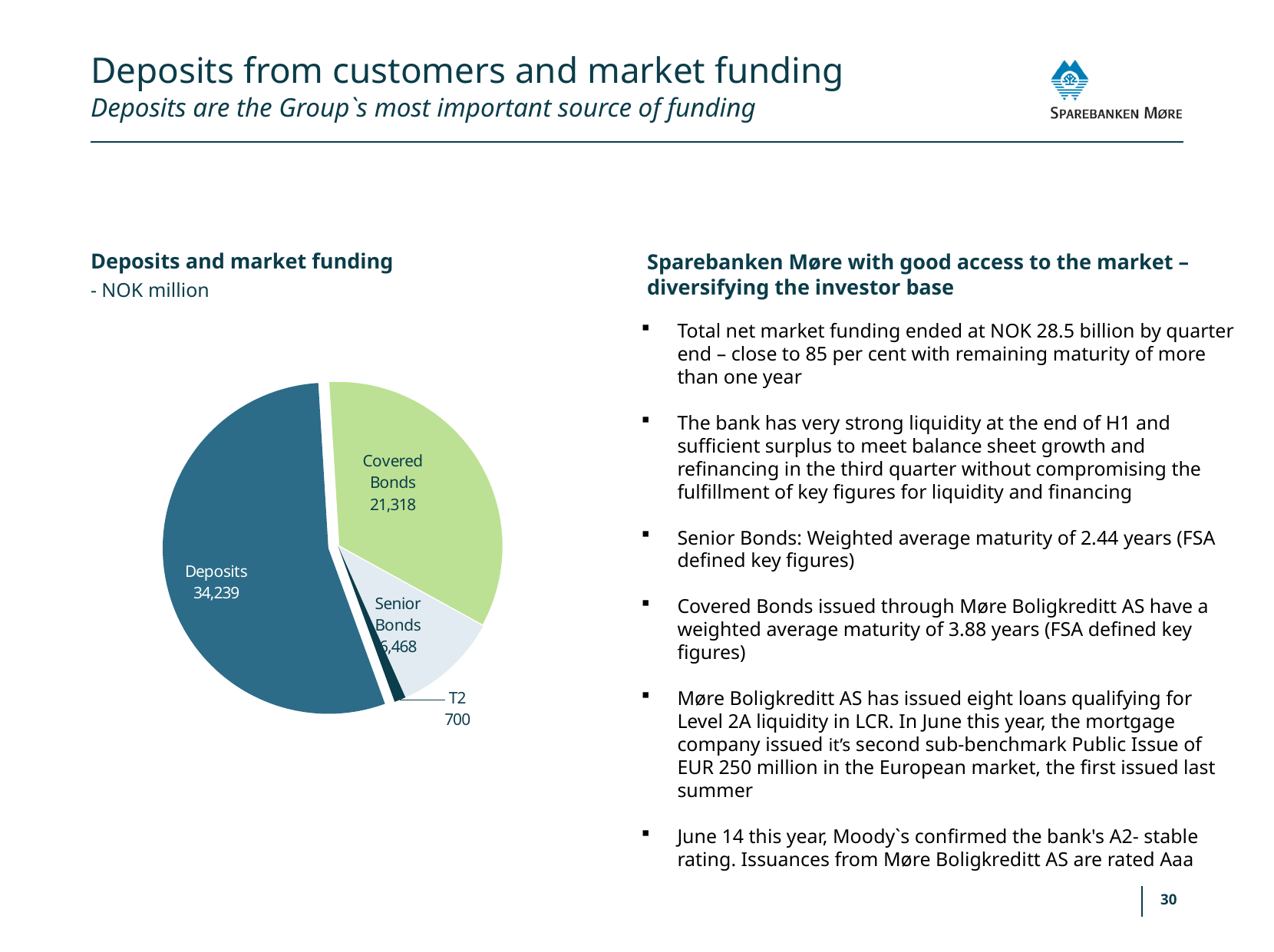
Which is larger, Covered Bonds or Senior Bonds? Covered Bonds What is the difference between the Deposits value and the Covered Bonds value? 12,921 How many slices does the pie chart have? 4 What is the title of the pie chart? Deposits and market funding What is the value for T2 in the pie chart? 700 What is the difference between the Covered Bonds value and the T2 value? 20,618 What is the value for Covered Bonds in the pie chart? 21,318 What kind of chart is shown on the slide? pie chart In what unit are the pie chart values given? NOK million Which category has the largest slice in the pie chart? Deposits Which category has the smallest slice in the pie chart? T2 What is the value for Deposits in the pie chart? 34,239